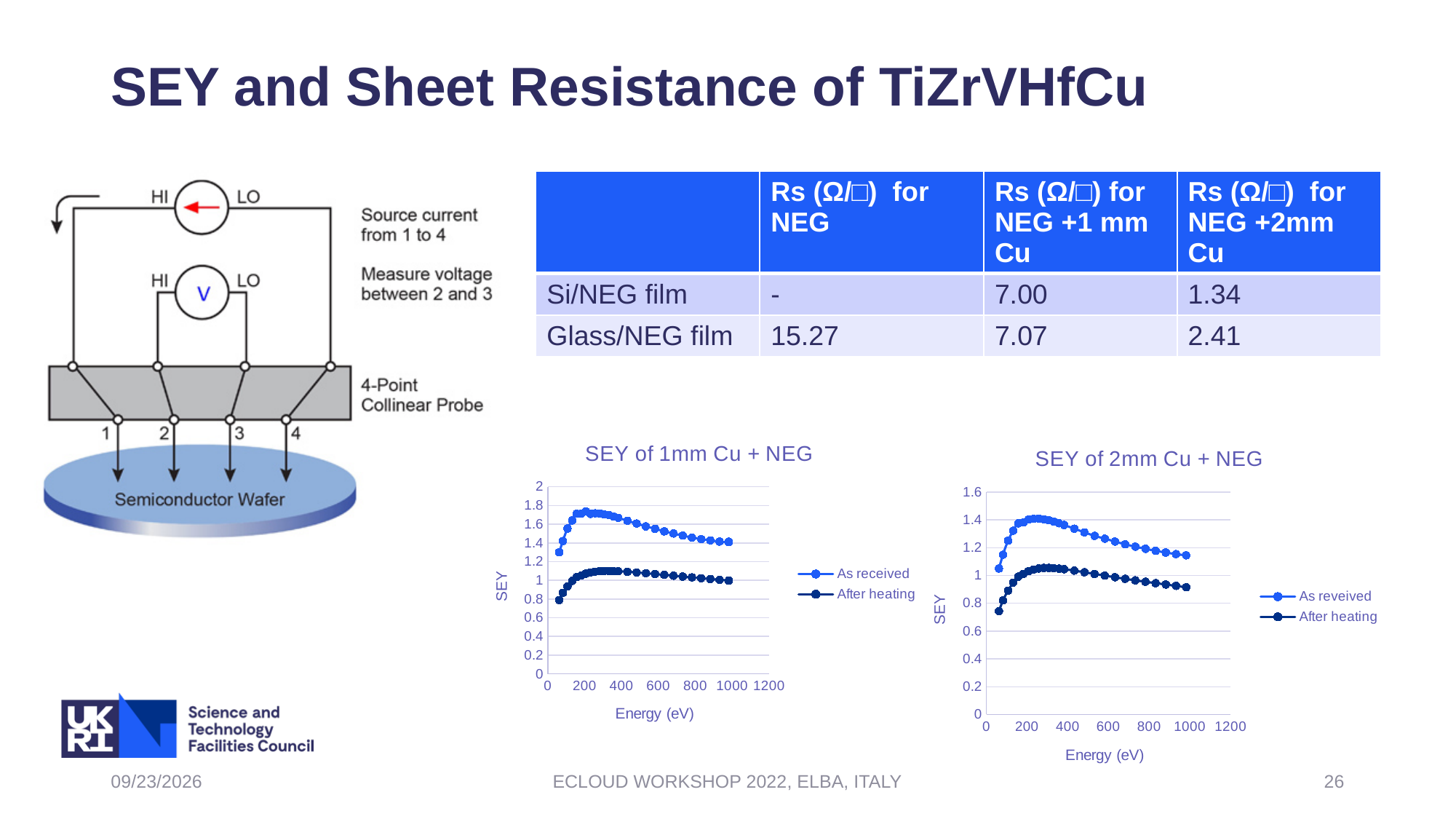
In "SEY of 2mm Cu + NEG", do the After heating values rise or fall as energy increases from 0 to 200 eV? rise In "SEY of 1mm Cu + NEG", is the After heating value at 1000 eV greater or less than 1.2? less In "SEY of 2mm Cu + NEG", which series has the lower SEY at 200 eV, As reveived or After heating? After heating In "SEY of 1mm Cu + NEG", is the As received value at 1000 eV greater or less than 1.2? greater How many series does the legend of "SEY of 2mm Cu + NEG" list? 2 What kind of chart is "SEY of 1mm Cu + NEG"? Line chart with markers (scatter) In "SEY of 1mm Cu + NEG", do the As received values rise or fall as energy increases from 400 eV to 1000 eV? fall What are the two legend entries in the "SEY of 1mm Cu + NEG" chart? As received, After heating In "SEY of 2mm Cu + NEG", is the peak As received value greater or less than 1.2? greater In "SEY of 1mm Cu + NEG", which series has the higher SEY at 600 eV, As received or After heating? As received What is the x-axis label of the "SEY of 2mm Cu + NEG" chart? Energy (eV)